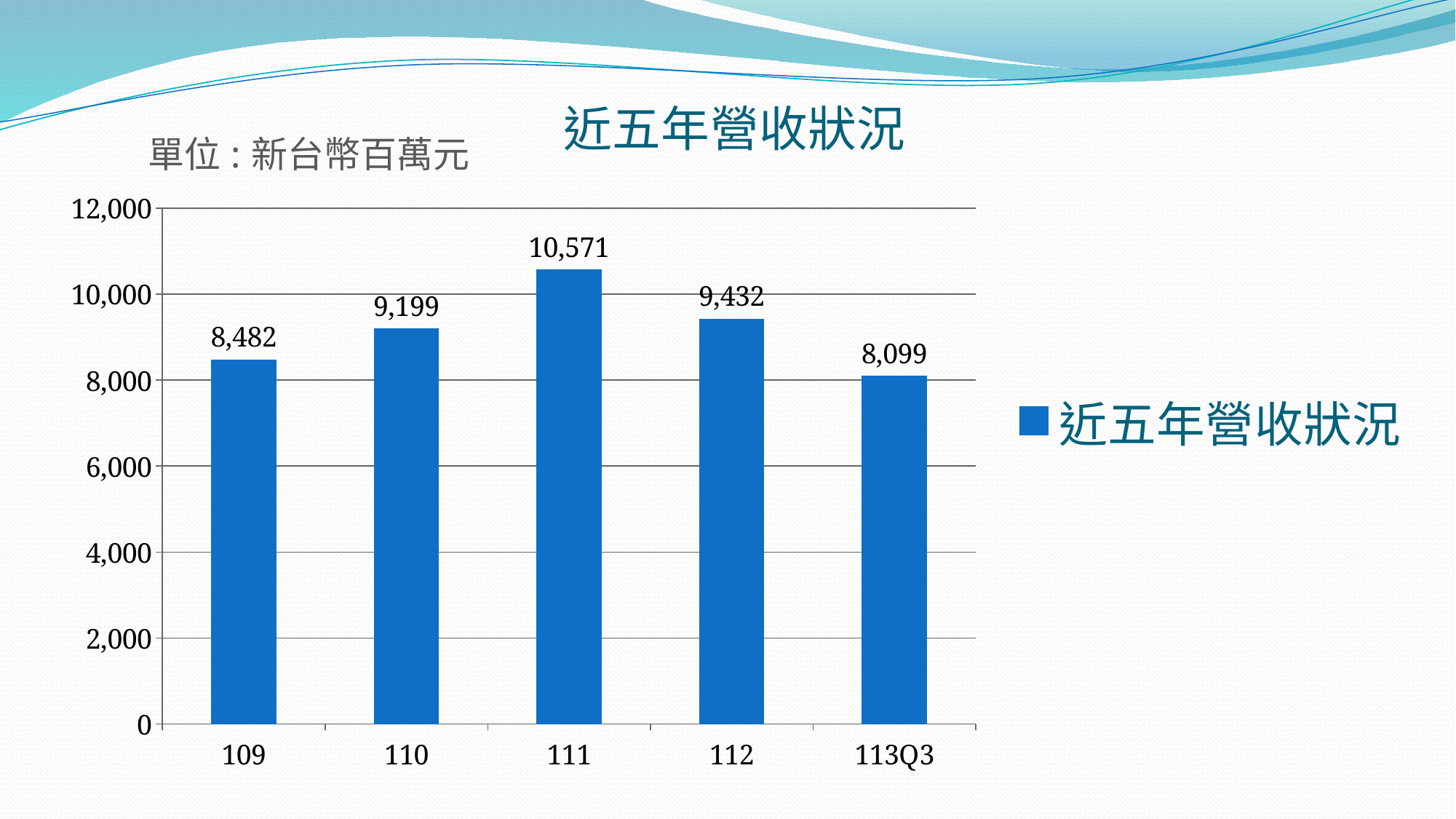
What kind of chart is shown? bar chart How many categories are shown on the x axis? 5 Which is larger, the value for 110 or the value for 112? 112 What is the difference between the values for 110 and 109? 717 What is the value for 113Q3? 8,099 What is the value for 111? 10,571 What is the difference between the values for 111 and 112? 1,139 What is the title of the chart? 近五年營收狀況 Is the value for 111 greater or less than 10,000? greater Which category has the highest value? 111 Which category has the lowest value? 113Q3 What is the value for 109? 8,482